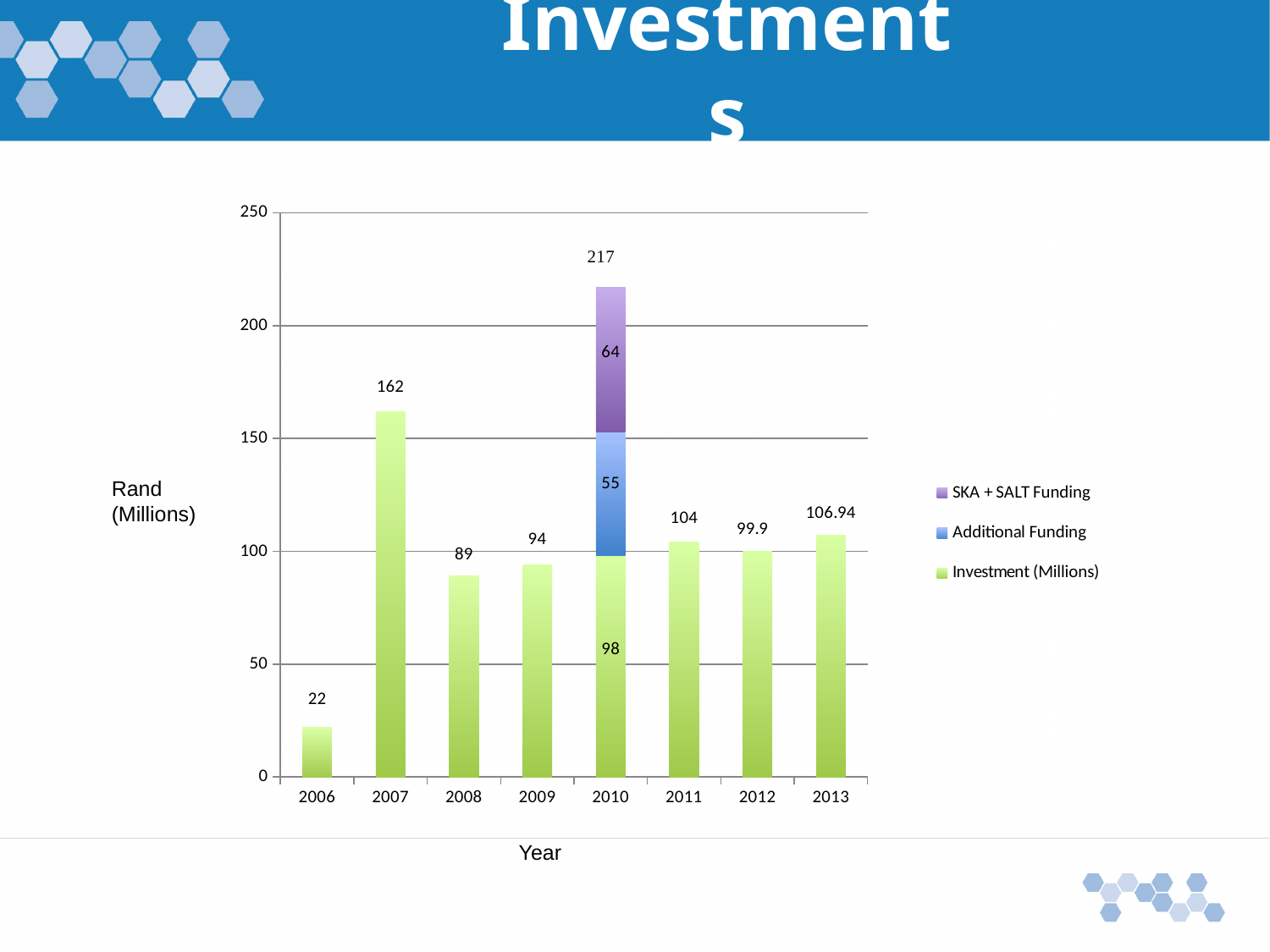
What is the Investment (Millions) value for 2013? 106.94 What is the SKA + SALT Funding value for 2010? 64 Which year has the lowest Investment (Millions) value? 2006 How many series does the legend list? 3 What is the Additional Funding value for 2010? 55 What is the difference between the Investment (Millions) values for 2007 and 2006? 140 Which is larger, the Investment (Millions) value for 2011 or for 2012? 2011 Which year has the highest Investment (Millions) value? 2007 What is the Investment (Millions) value for 2007? 162 How many years are shown on the x axis? 8 What is the total of the stacked bar for 2010? 217 What kind of chart is shown on the slide? Stacked bar chart